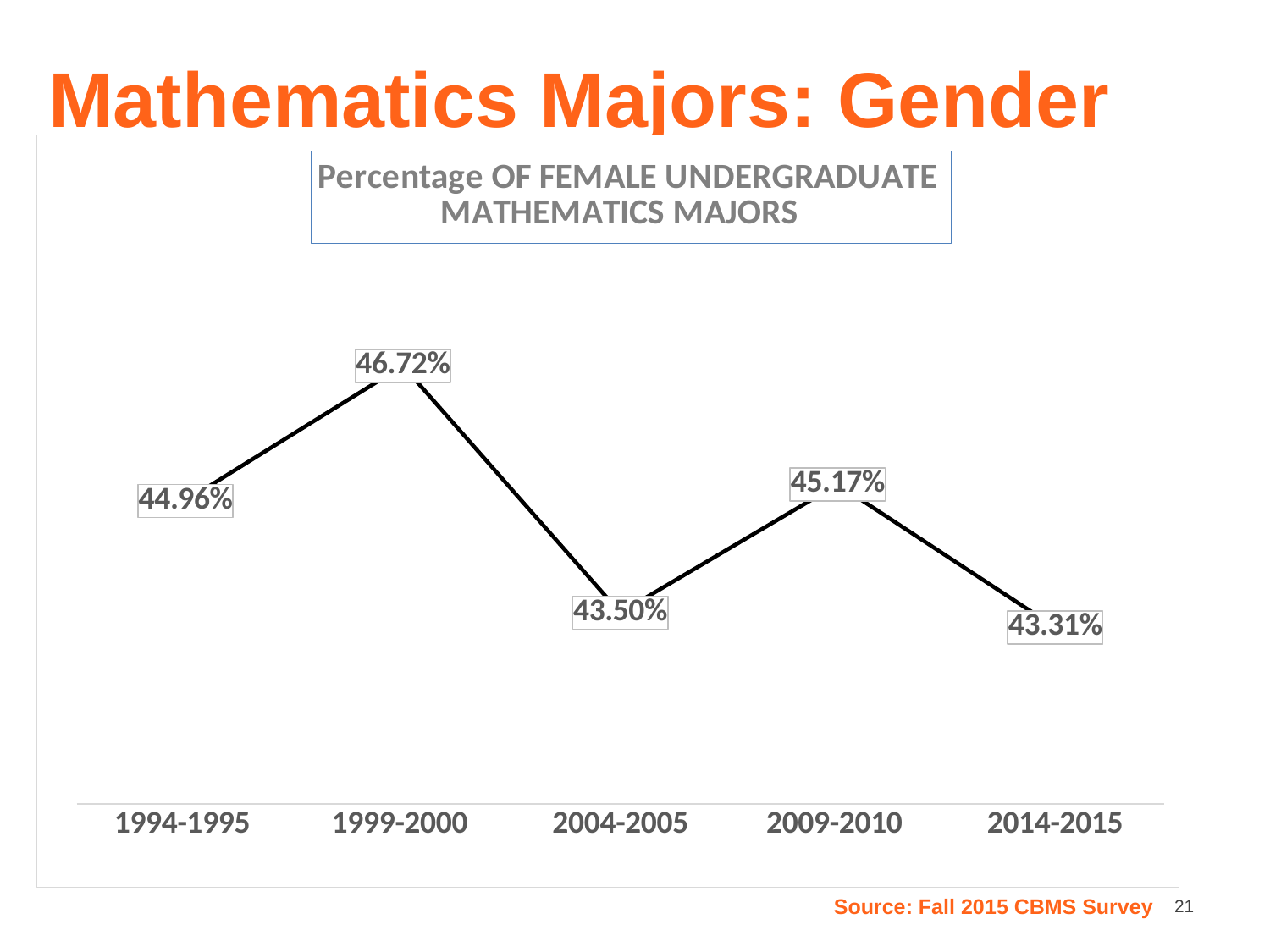
Which period has the lowest percentage of female undergraduate mathematics majors? 2014-2015 What is the percentage of female undergraduate mathematics majors in 2014-2015? 43.31% What is the percentage of female undergraduate mathematics majors in 1994-1995? 44.96% What is the title of the chart? Percentage OF FEMALE UNDERGRADUATE MATHEMATICS MAJORS What is the difference in percentage points between 1999-2000 and 2004-2005? 3.22 What is the percentage of female undergraduate mathematics majors in 1999-2000? 46.72% Which period has the highest percentage of female undergraduate mathematics majors? 1999-2000 What kind of chart is shown on the slide? Line chart Does the percentage rise or fall from 2009-2010 to 2014-2015? Fall What is the percentage of female undergraduate mathematics majors in 2004-2005? 43.50% How many time periods are plotted on the chart? 5 Which period has a higher percentage of female mathematics majors, 1994-1995 or 2009-2010? 2009-2010